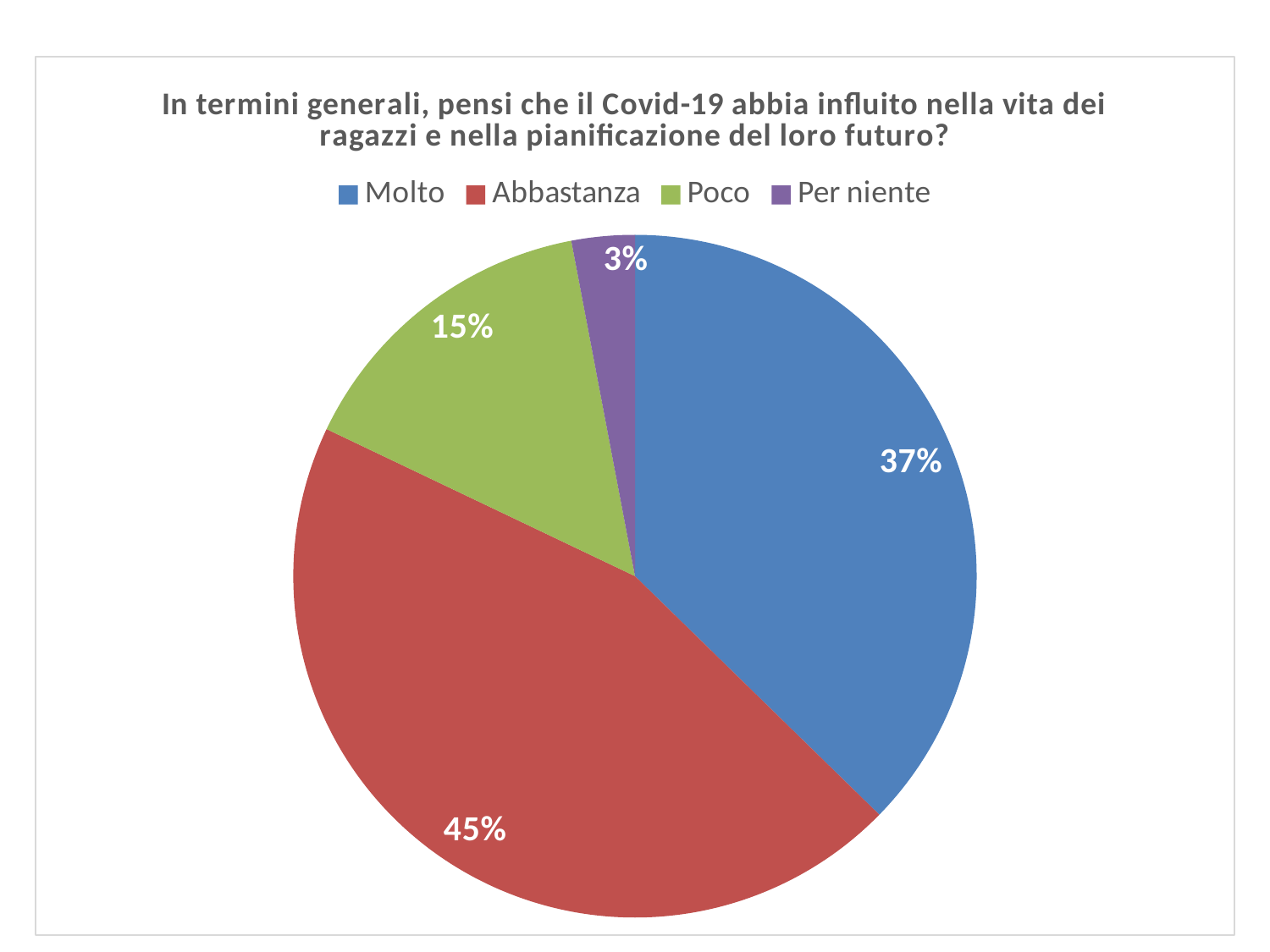
What percentage of respondents answered "Molto"? 37% What type of chart is shown on the slide? pie chart Which response has the smallest share of the pie? Per niente What percentage of respondents answered "Per niente"? 3% What colour is the "Abbastanza" slice? red What percentage of respondents answered "Poco"? 15% What percentage of respondents answered "Abbastanza"? 45% What is the difference in percentage points between "Abbastanza" and "Molto"? 8 What is the combined share of "Molto" and "Abbastanza"? 82% Which response has the largest share of the pie? Abbastanza Which is larger, the share for "Poco" or the share for "Per niente"? Poco How many categories does the pie chart show? 4